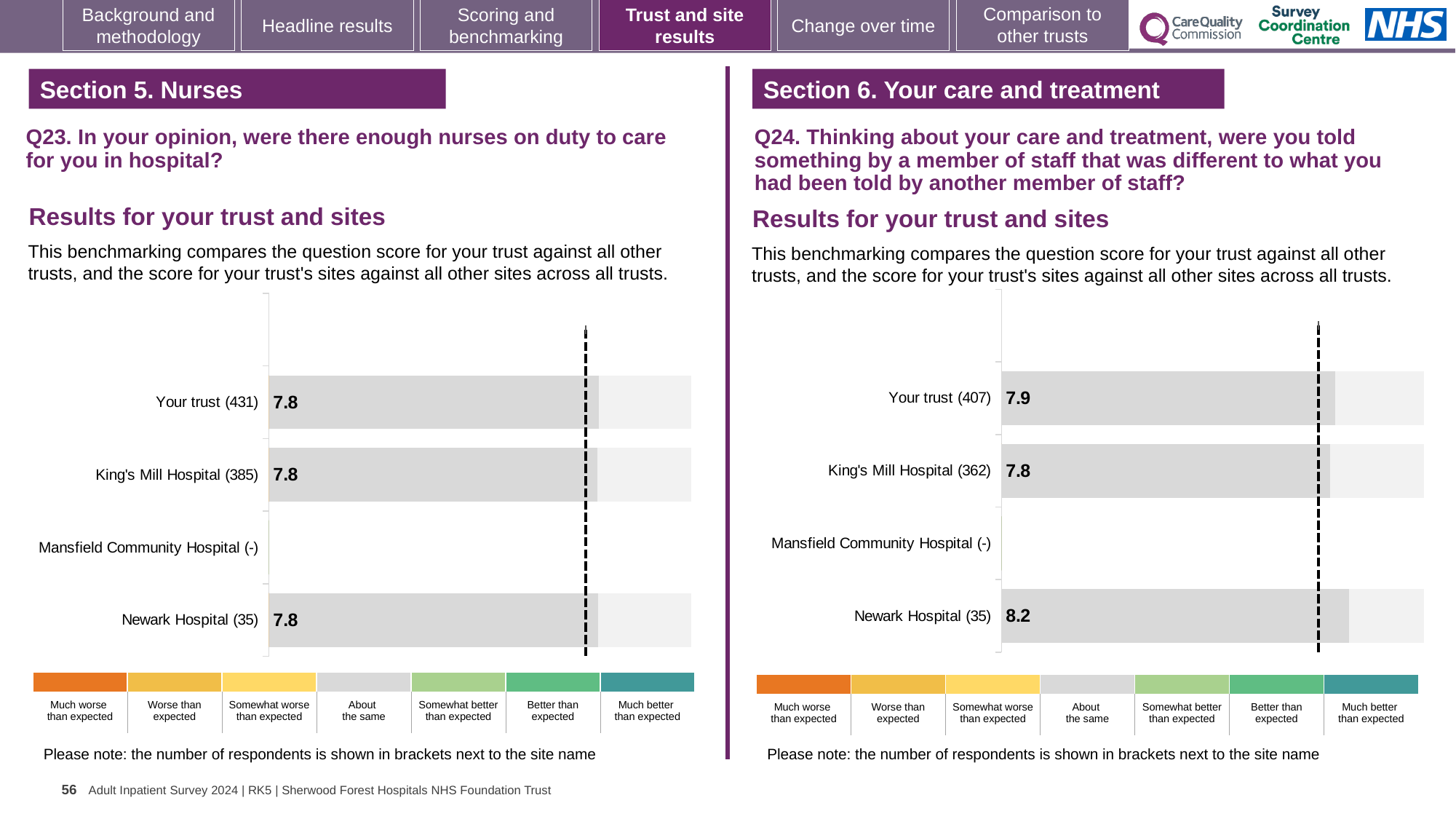
On the Q24 chart (right), what is the score for Your trust (407)? 7.9 On the Q24 chart (right), which has the larger score, Newark Hospital (35) or King's Mill Hospital (362)? Newark Hospital (35) On the Q24 chart (right), what is the score for Newark Hospital (35)? 8.2 On the Q24 chart (right), which site or trust has the highest score? Newark Hospital (35) What type of chart is used on the Q23 chart (left)? Bar chart On the Q24 chart (right), which of the plotted scores is the lowest? King's Mill Hospital (362) How many categories (trust and sites) are listed on the Q23 chart (left)? 4 On the Q23 chart (left), what is the score for Newark Hospital (35)? 7.8 How many benchmark categories are shown in the colour legend below the Q24 chart (right)? 7 On the Q23 chart (left), what is the score for Your trust (431)? 7.8 On the Q24 chart (right), what is the score for King's Mill Hospital (362)? 7.8 On the Q24 chart (right), what is the difference between the scores for Newark Hospital (35) and Your trust (407)? 0.3